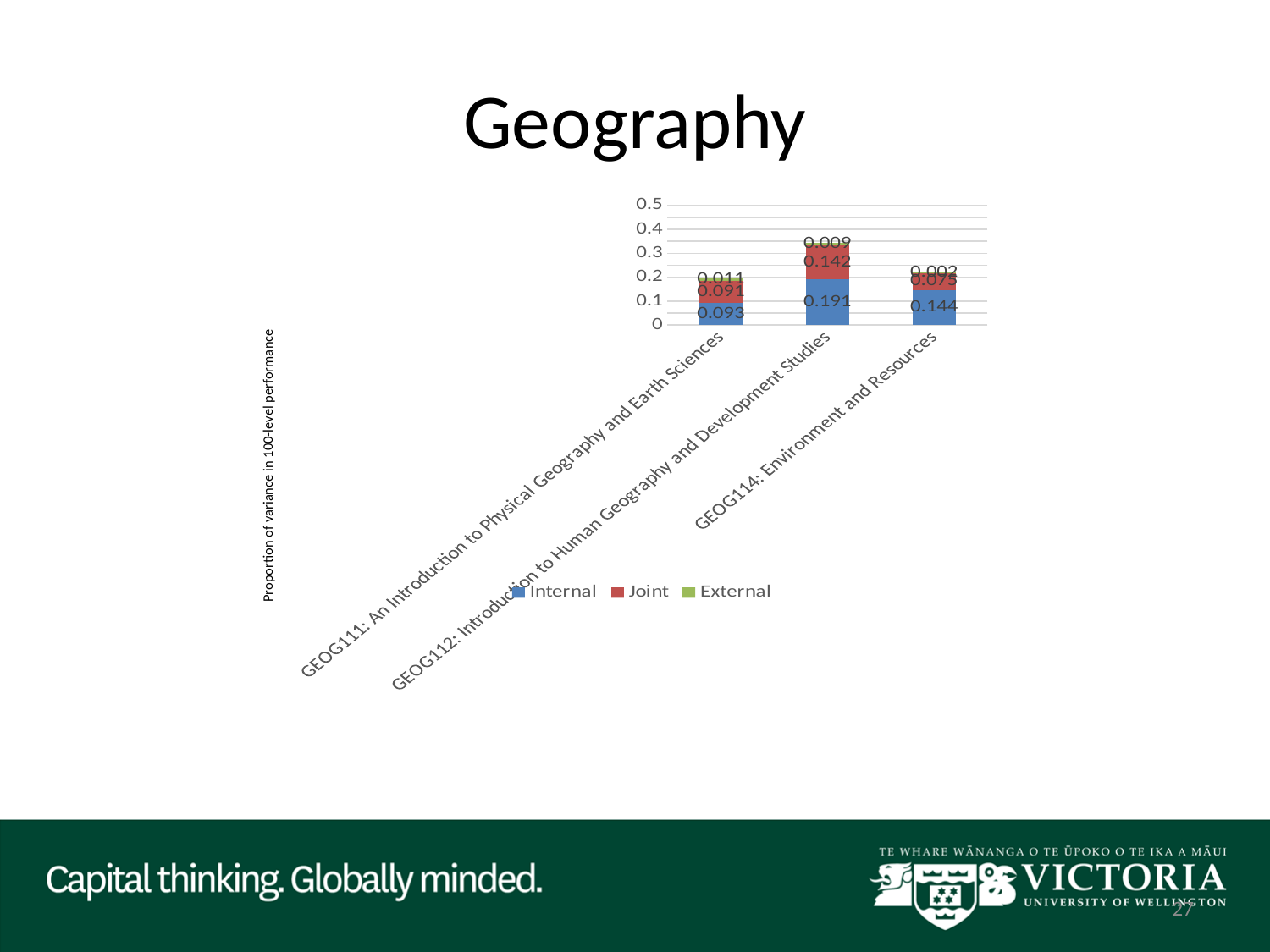
What kind of chart is shown on the slide? Stacked bar chart What is the difference between the Internal values for GEOG112 and GEOG111? 0.098 Is the Joint value larger for GEOG112 or for GEOG114? GEOG112 How many series does the legend list? 3 Which course has the highest Internal value? GEOG112: Introduction to Human Geography and Development Studies Which course has the lowest Joint value? GEOG114: Environment and Resources What is the Internal value for GEOG112: Introduction to Human Geography and Development Studies? 0.191 What is the External value for GEOG114: Environment and Resources? 0.002 How many courses are shown on the x axis? 3 Is the total stacked value for GEOG112 greater or less than 0.3? greater What is the Joint value for GEOG111: An Introduction to Physical Geography and Earth Sciences? 0.091 What is the total of the stacked bar for GEOG111: An Introduction to Physical Geography and Earth Sciences? 0.195